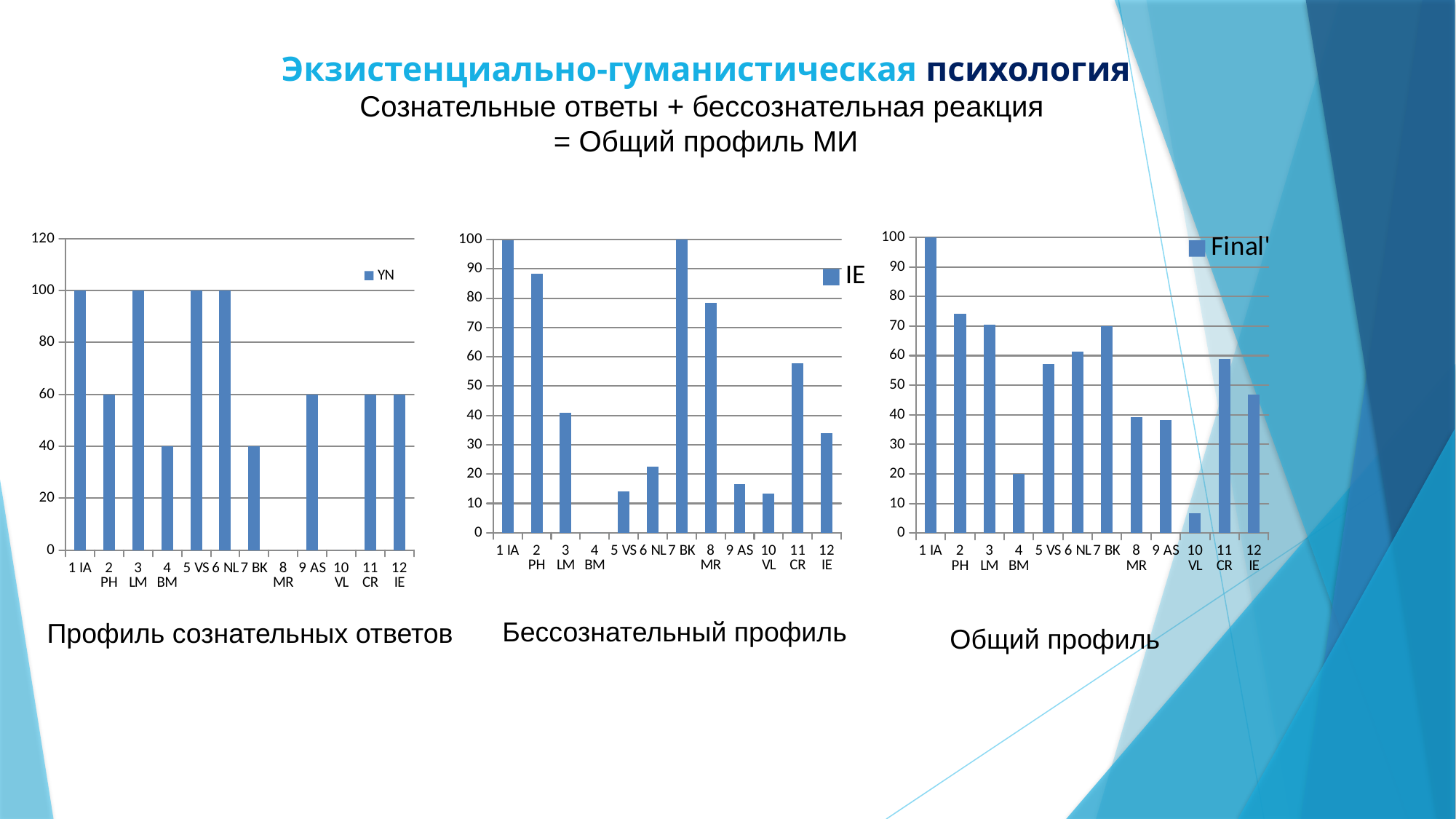
In the middle chart (Бессознательный профиль), is the value for 5 VS greater or less than 20? less In the right chart (Общий профиль), which category has the lowest value? 10 VL In the left chart (Профиль сознательных ответов), what is the value for 2 PH? 60 In the left chart (Профиль сознательных ответов), what series name does the legend show? YN In the right chart (Общий профиль), what is the value for 4 BM? 20 In the middle chart (Бессознательный профиль), is the value for 2 PH greater or less than 80? greater In the left chart (Профиль сознательных ответов), how many categories are shown on the x axis? 12 In the middle chart (Бессознательный профиль), what is the value for 7 BK? 100 In the left chart (Профиль сознательных ответов), what is the difference between the values for 1 IA and 7 BK? 60 In the middle chart (Бессознательный профиль), which is larger, the value for 3 LM or the value for 10 VL? 3 LM What type of chart is the right chart (Общий профиль)? Bar chart In the left chart (Профиль сознательных ответов), what is the value for 4 BM? 40